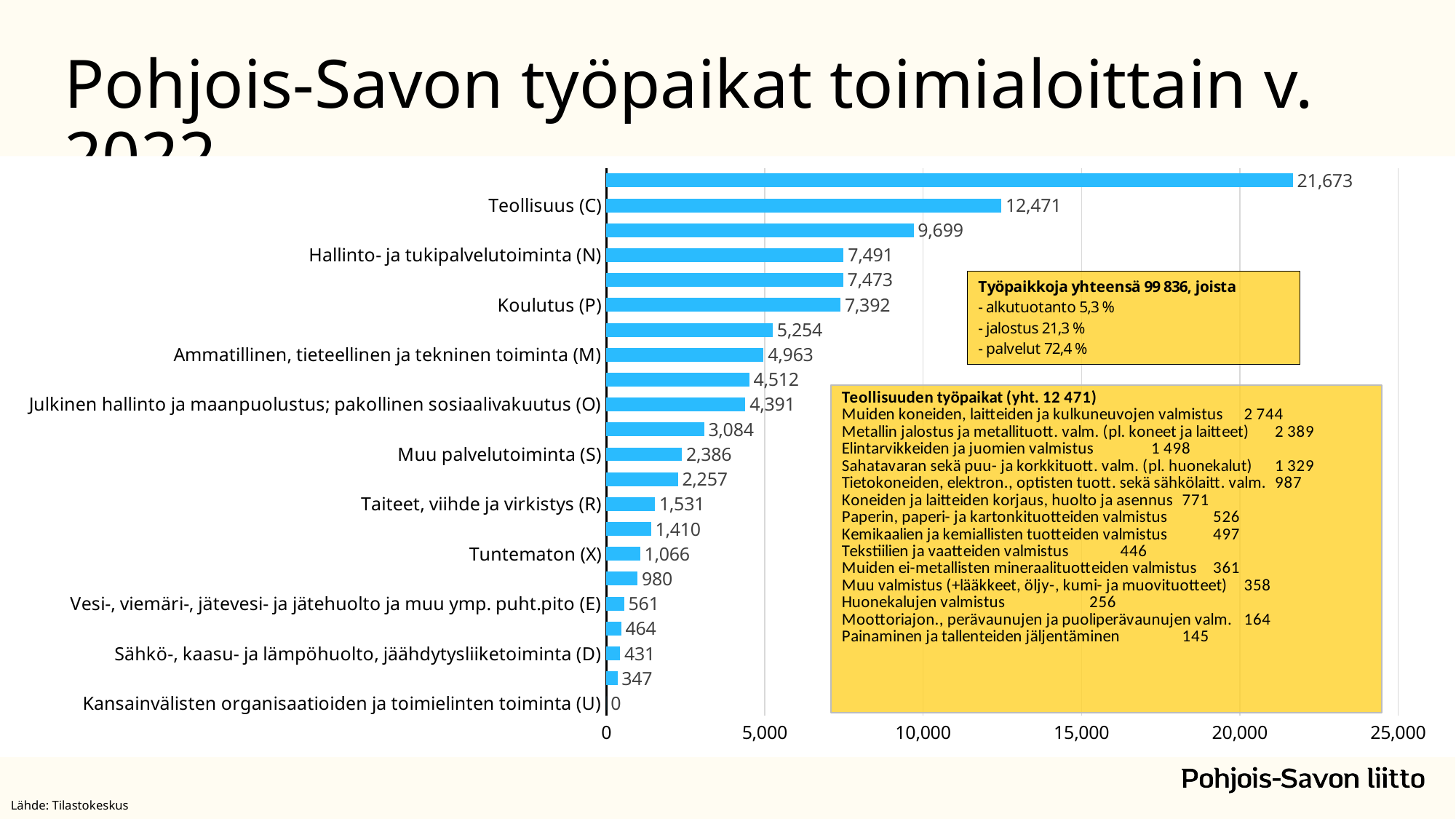
What is the value for Koulutus (P)? 7,392 Which is larger, Muu palvelutoiminta (S) or Taiteet, viihde ja virkistys (R)? Muu palvelutoiminta (S) What is the largest value labelled on any bar in the chart? 21,673 Which labelled category has the lowest value? Kansainvälisten organisaatioiden ja toimielinten toiminta (U) What is the value for Taiteet, viihde ja virkistys (R)? 1,531 Is the value for Teollisuus (C) greater or less than 10,000? greater How many bars are plotted in the chart? 22 What is the value for Tuntematon (X)? 1,066 What type of chart is shown on the slide? bar chart What is the value for Teollisuus (C)? 12,471 What is the difference between Teollisuus (C) and Koulutus (P)? 5,079 What is the value for Hallinto- ja tukipalvelutoiminta (N)? 7,491